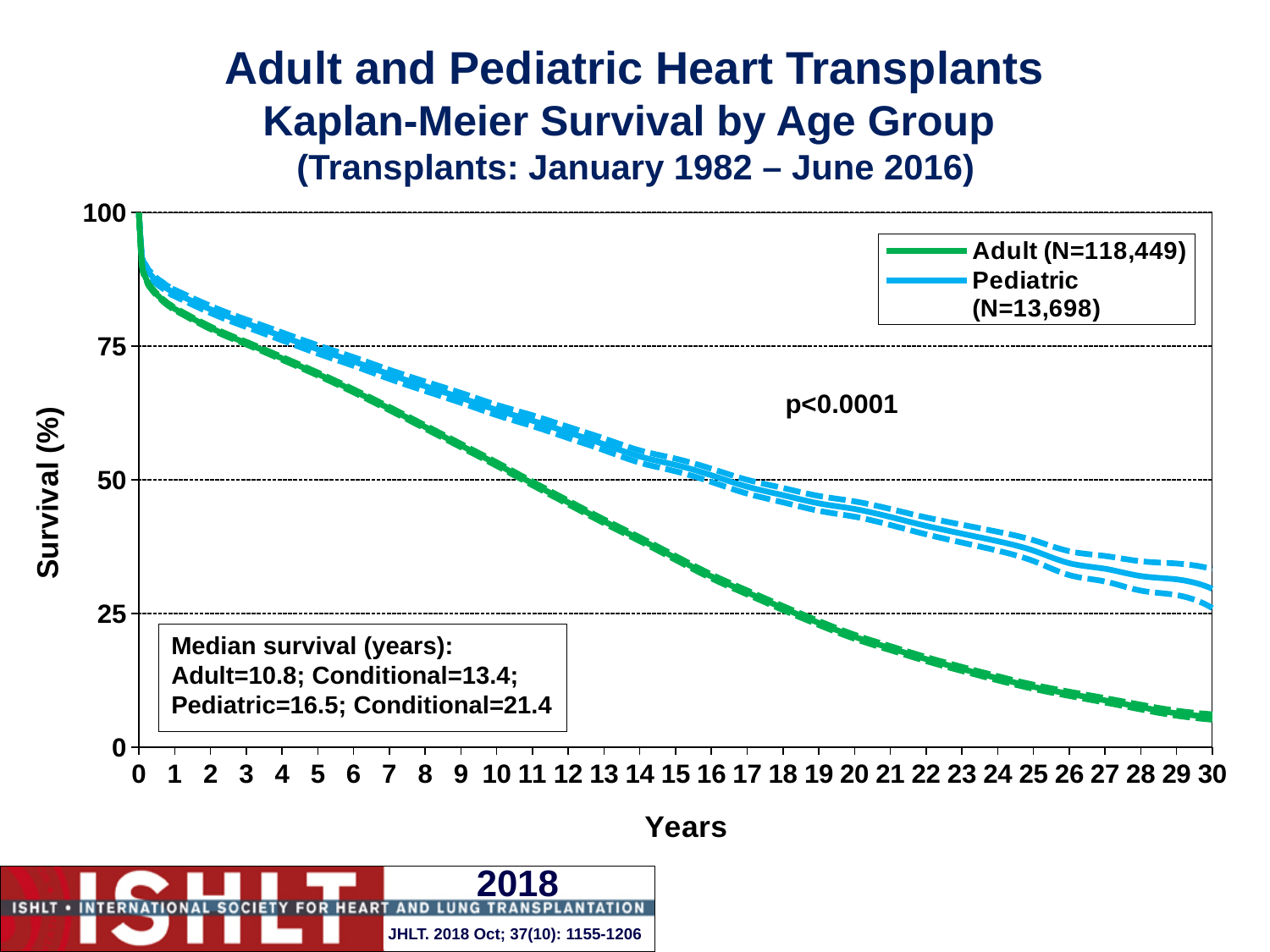
What kind of chart is shown on the slide? line chart Is the Adult survival at 30 years greater or less than 25? less At 20 years, which group has the higher survival, Adult or Pediatric? Pediatric What is the median survival in years for Pediatric recipients, as printed in the text box? 16.5 What is the median survival in years for Adult recipients, as printed in the text box? 10.8 Do the survival curves rise or fall as years increase? fall Is the Adult survival at 5 years greater or less than 75? less What is the conditional median survival in years for Pediatric recipients, as printed in the text box? 21.4 What p-value is printed on the chart? p<0.0001 What is the N for the Adult group shown in the legend? 118,449 Is the Pediatric survival at 10 years greater or less than 50? greater How many series does the legend list? 2